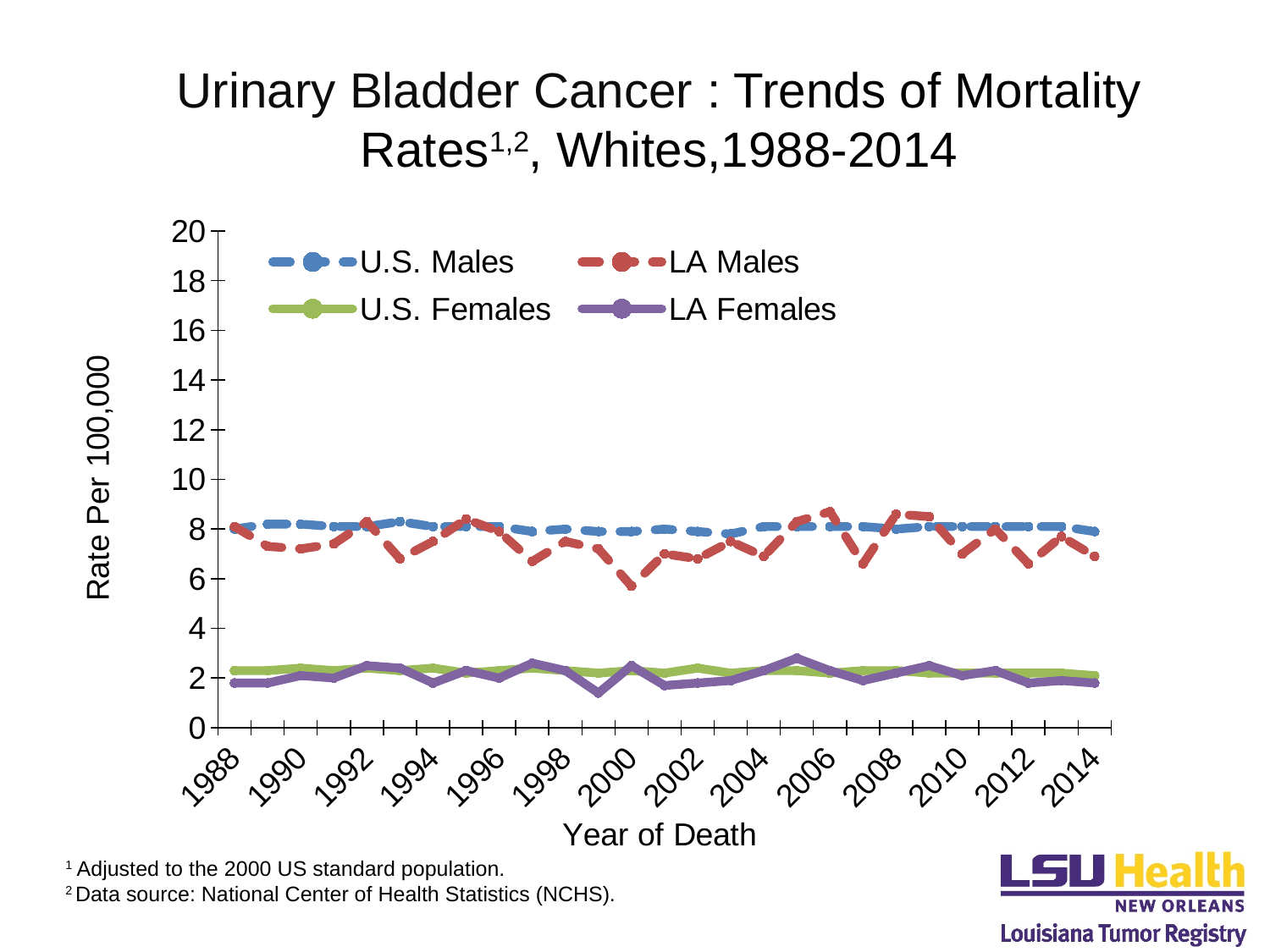
Which series has the lowest value in 1999? LA Females How many years are plotted along the x axis, from 1988 to 2014? 27 What is the label of the vertical axis? Rate Per 100,000 Is the value for LA Males in 2006 greater or less than 8? greater Is the value for LA Males in 2000 greater or less than 8? less Is the value for U.S. Females in 2014 greater or less than 4? less In 2010, which is larger: the value for U.S. Males or the value for U.S. Females? U.S. Males What kind of chart is shown on the slide? Line chart How many series does the legend list? 4 Which series are listed in the legend? U.S. Males, LA Males, U.S. Females, LA Females